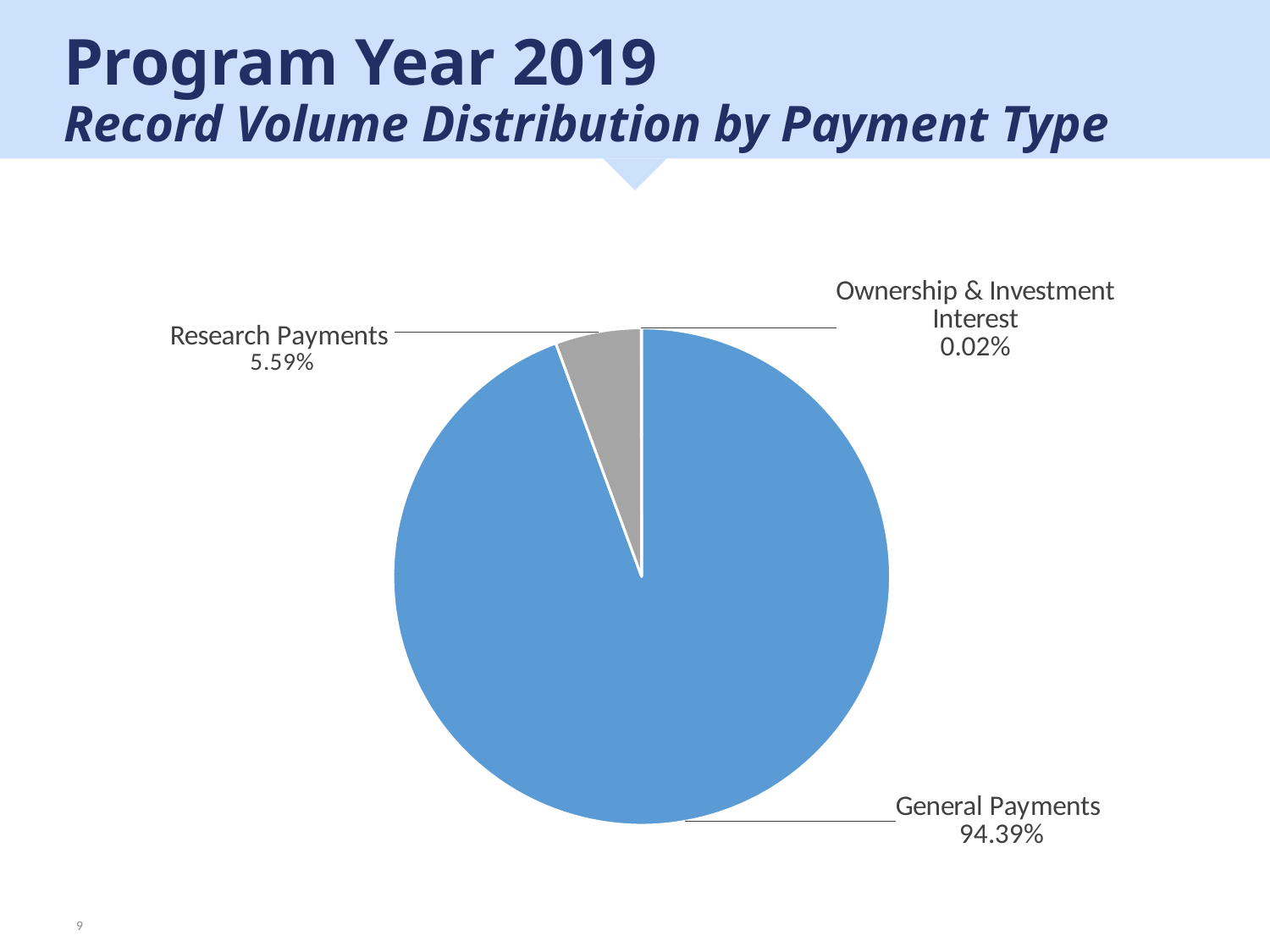
Which has a larger share, Research Payments or Ownership & Investment Interest? Research Payments Which payment type has the smallest share of record volume? Ownership & Investment Interest Which payment type has the largest share of record volume? General Payments What share of record volume is Research Payments? 5.59% What colour is the General Payments slice? blue What is the difference in percentage points between General Payments and Research Payments? 88.80 percentage points How many payment types are shown in the pie chart? 3 What share of record volume is Ownership & Investment Interest? 0.02% What is the title of the slide containing the pie chart? Program Year 2019 Record Volume Distribution by Payment Type What share of record volume is General Payments? 94.39% What is the difference in percentage points between Research Payments and Ownership & Investment Interest? 5.57 percentage points What kind of chart is shown on the slide? pie chart